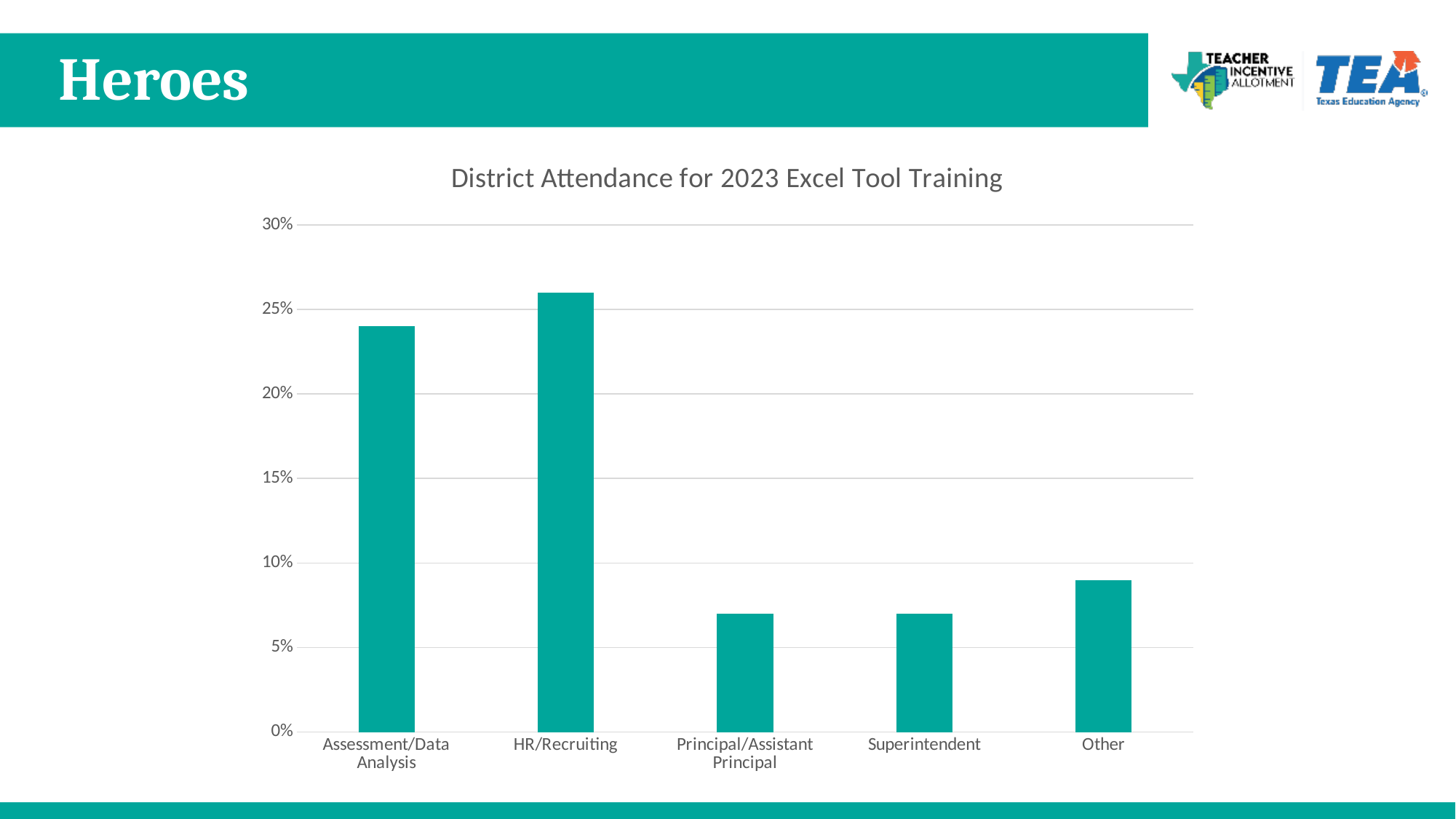
Is the value for Assessment/Data Analysis greater or less than 25%? less Is the value for Superintendent greater or less than 10%? less What is the title of the chart? District Attendance for 2023 Excel Tool Training Is the value for Other greater or less than 10%? less Which category has the highest attendance in the chart? HR/Recruiting How many categories are shown on the x axis of the chart? 5 What type of chart is shown on the slide? Bar chart Which is larger, the value for Assessment/Data Analysis or the value for Other? Assessment/Data Analysis Which is larger, the value for Other or the value for Superintendent? Other